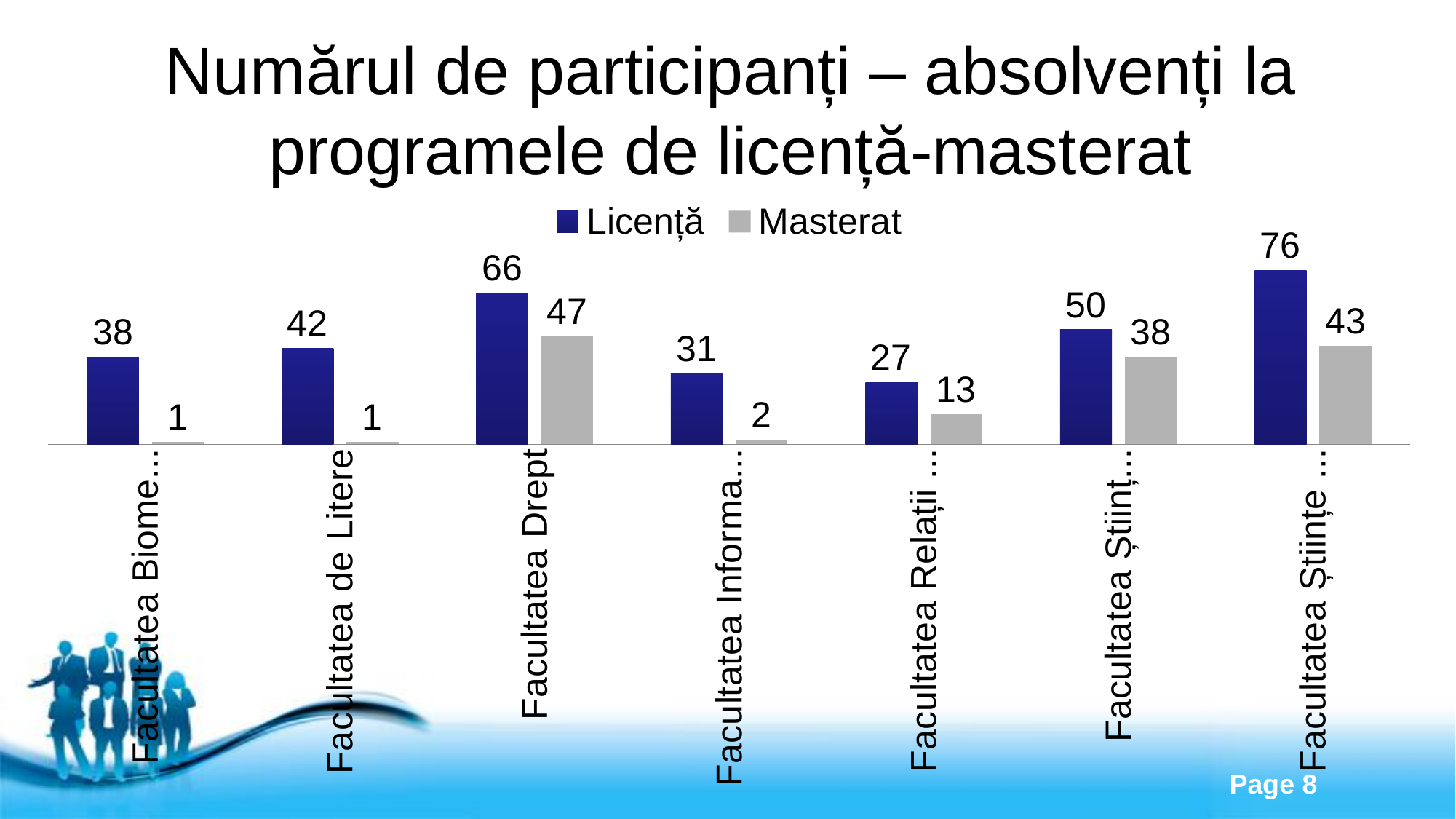
Which has the larger Licență value, Facultatea de Litere or Facultatea Drept? Facultatea Drept What is the Licență value for Facultatea de Litere? 42 What kind of chart is shown on the slide? bar chart How many series does the legend list? 2 What is the Licență value for Facultatea Drept? 66 What is the highest Masterat value shown in the chart? 47 What is the highest Licență value shown in the chart? 76 What is the difference between the Licență and Masterat values for Facultatea Drept? 19 What is the Masterat value for Facultatea de Litere? 1 What is the Masterat value for Facultatea Drept? 47 How many faculties (categories) are shown on the x axis? 7 What is the lowest Masterat value shown in the chart? 1